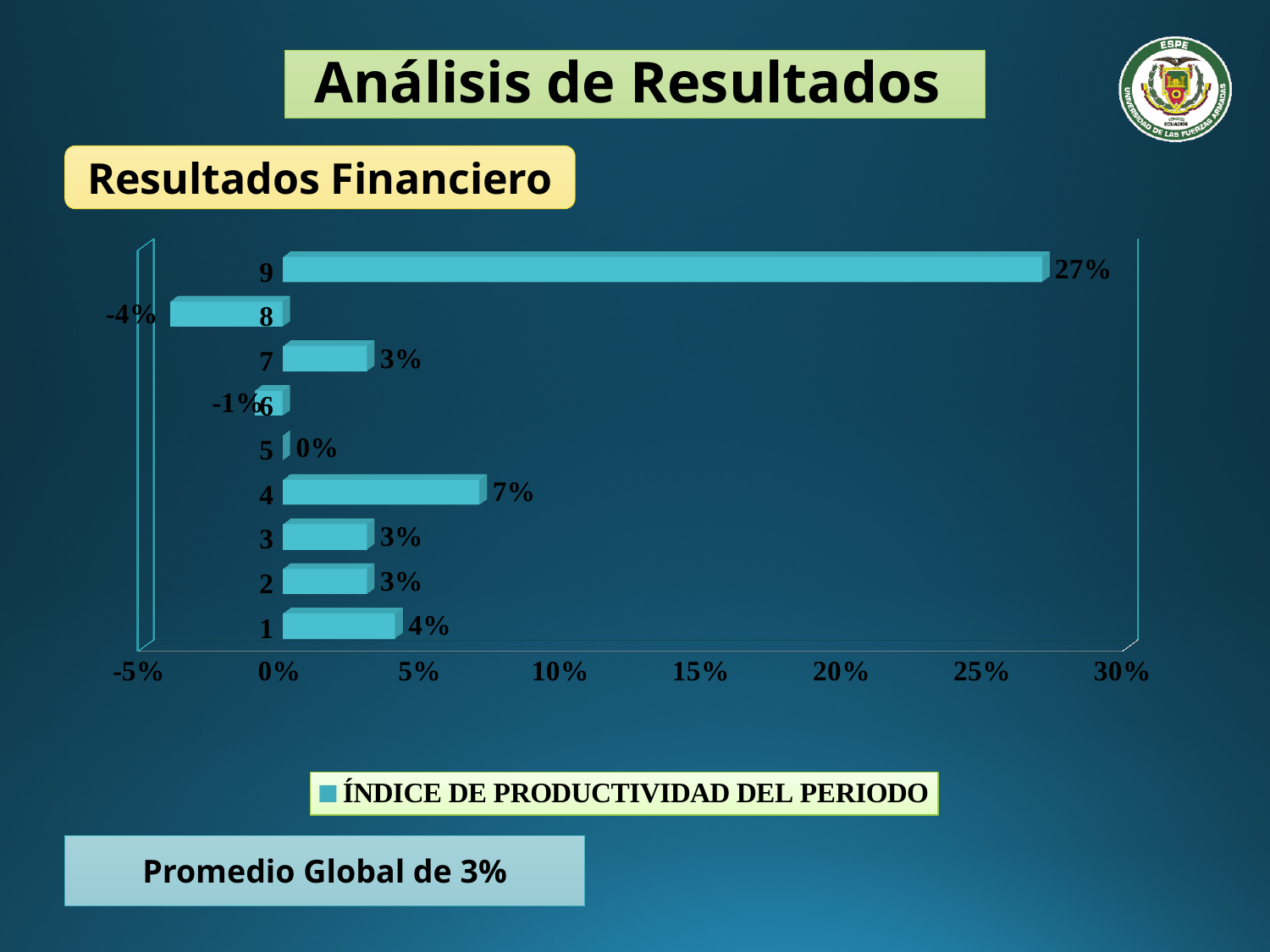
What is the value for category 6? -1% Is the value for category 9 greater or less than 25%? greater What is the value for category 9? 27% What kind of chart is shown on the slide? bar chart What is the value for category 8? -4% What series name does the legend show? ÍNDICE DE PRODUCTIVIDAD DEL PERIODO How many categories are shown in the chart? 9 What is the value for category 4? 7% Which category has the highest value? 9 What is the difference between the values for category 9 and category 4? 20% Which category has the lowest value? 8 Which is larger, the value for category 4 or the value for category 1? category 4